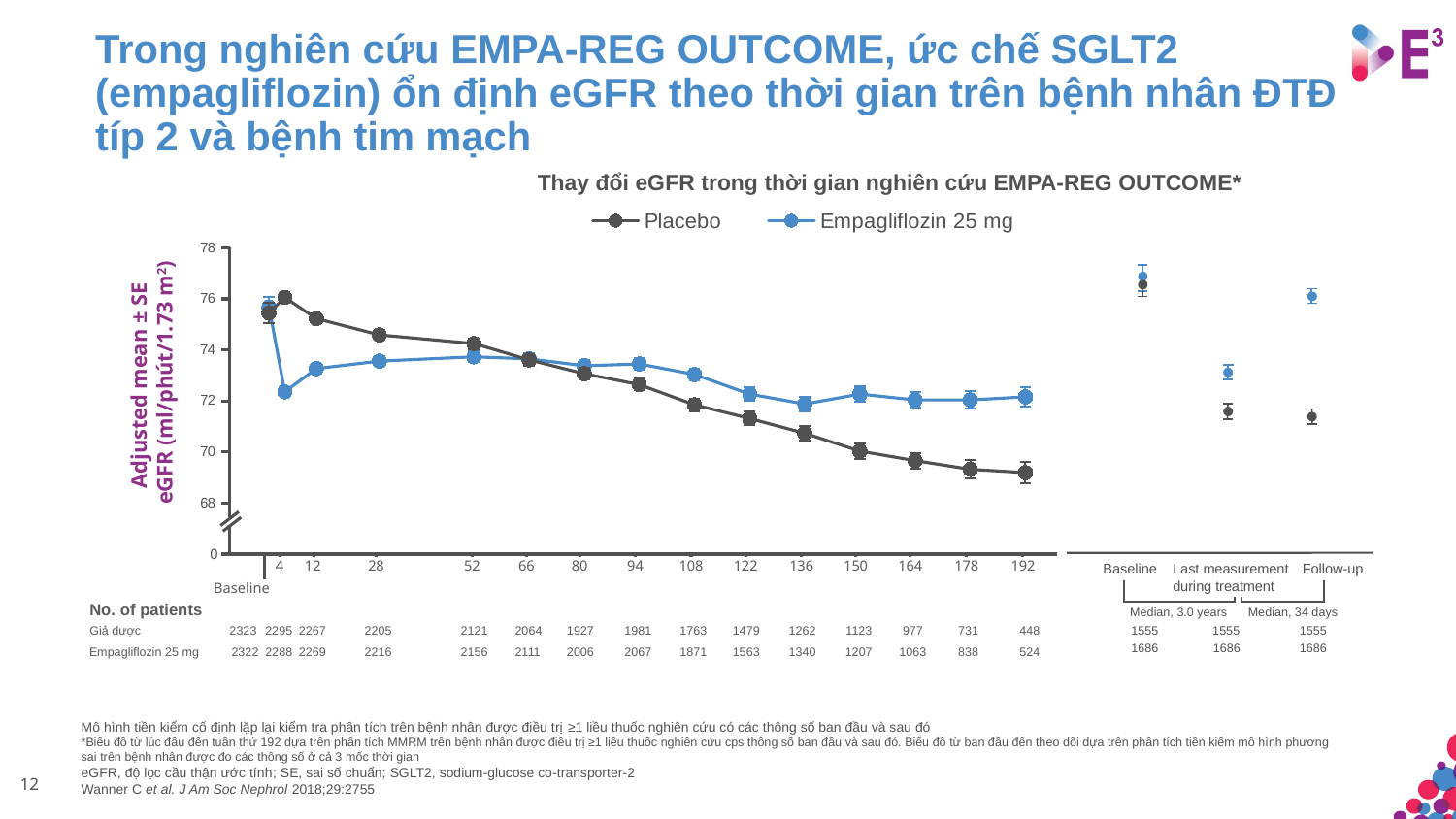
Does the Placebo series rise or fall from week 4 to week 192? Fall At week 4, which series has the higher eGFR value, Placebo or Empagliflozin 25 mg? Placebo Is the Empagliflozin 25 mg value at week 52 greater or less than 72? greater What kind of chart is shown on the slide? Line chart Is the Placebo value at Baseline greater or less than 76? less What are the two series named in the legend? Placebo and Empagliflozin 25 mg How many time points (including Baseline) are plotted along the x axis of the main chart? 15 How many series does the legend list? 2 Is the Placebo value at week 192 greater or less than 70? less At week 192, which series has the higher eGFR value, Placebo or Empagliflozin 25 mg? Empagliflozin 25 mg What is the title of the chart? Thay đổi eGFR trong thời gian nghiên cứu EMPA-REG OUTCOME*